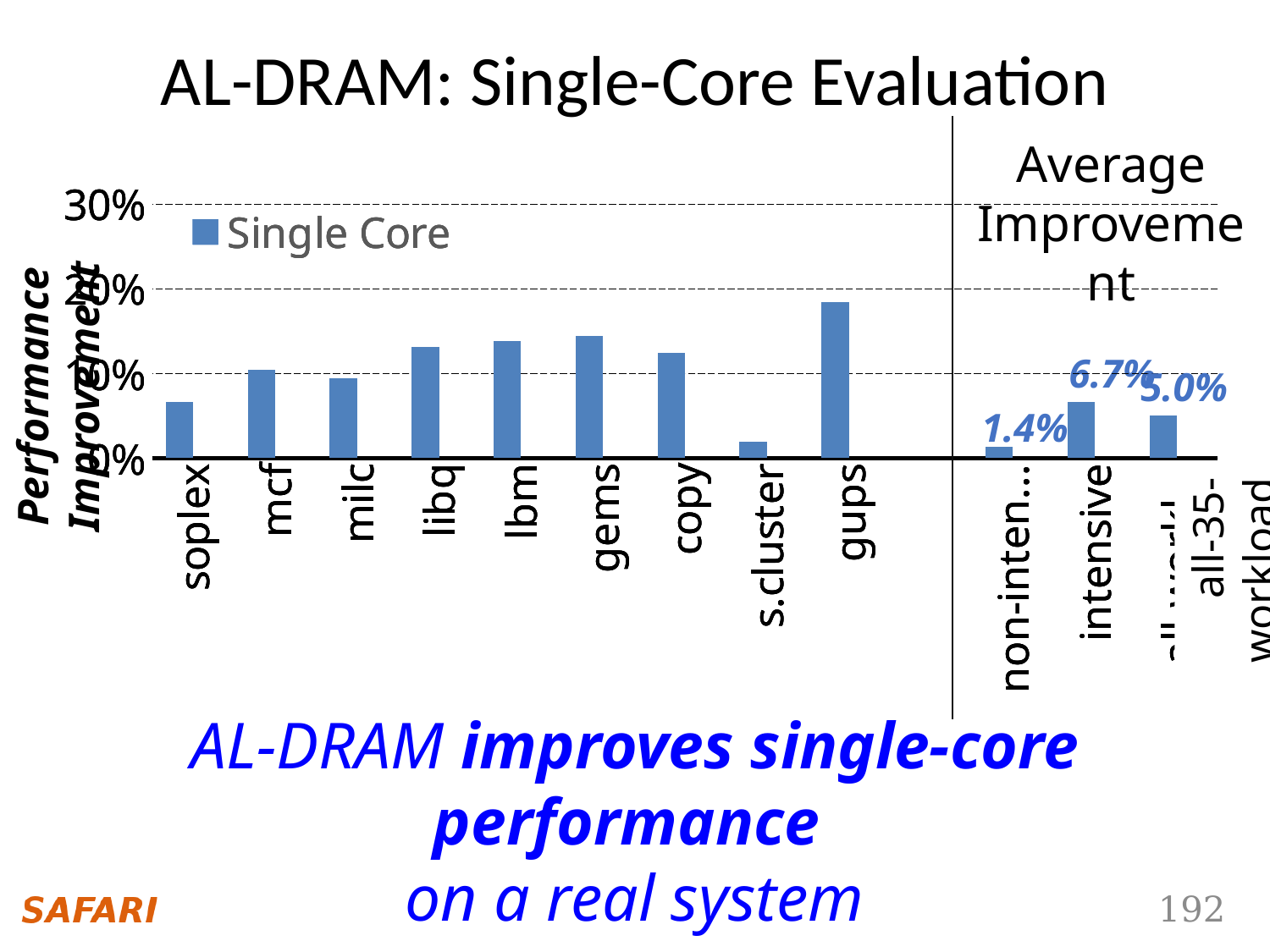
What is the value labelled for the intensive category? 6.7% What is the value labelled for the all-35-workload category? 5.0% Which is larger, the value for gups or the value for copy? gups What is the difference between the intensive and non-intensive average improvements? 5.3% Is the value for s.cluster greater or less than 10%? less How many categories are shown on the x axis? 12 Is the value for gups greater or less than 10%? greater What is the value labelled for the non-intensive category? 1.4% Among the nine benchmarks to the left of the vertical divider, which has the lowest performance improvement? s.cluster How many series does the legend list? 1 What kind of chart is shown on the slide? bar chart Which benchmark has the highest performance improvement? gups